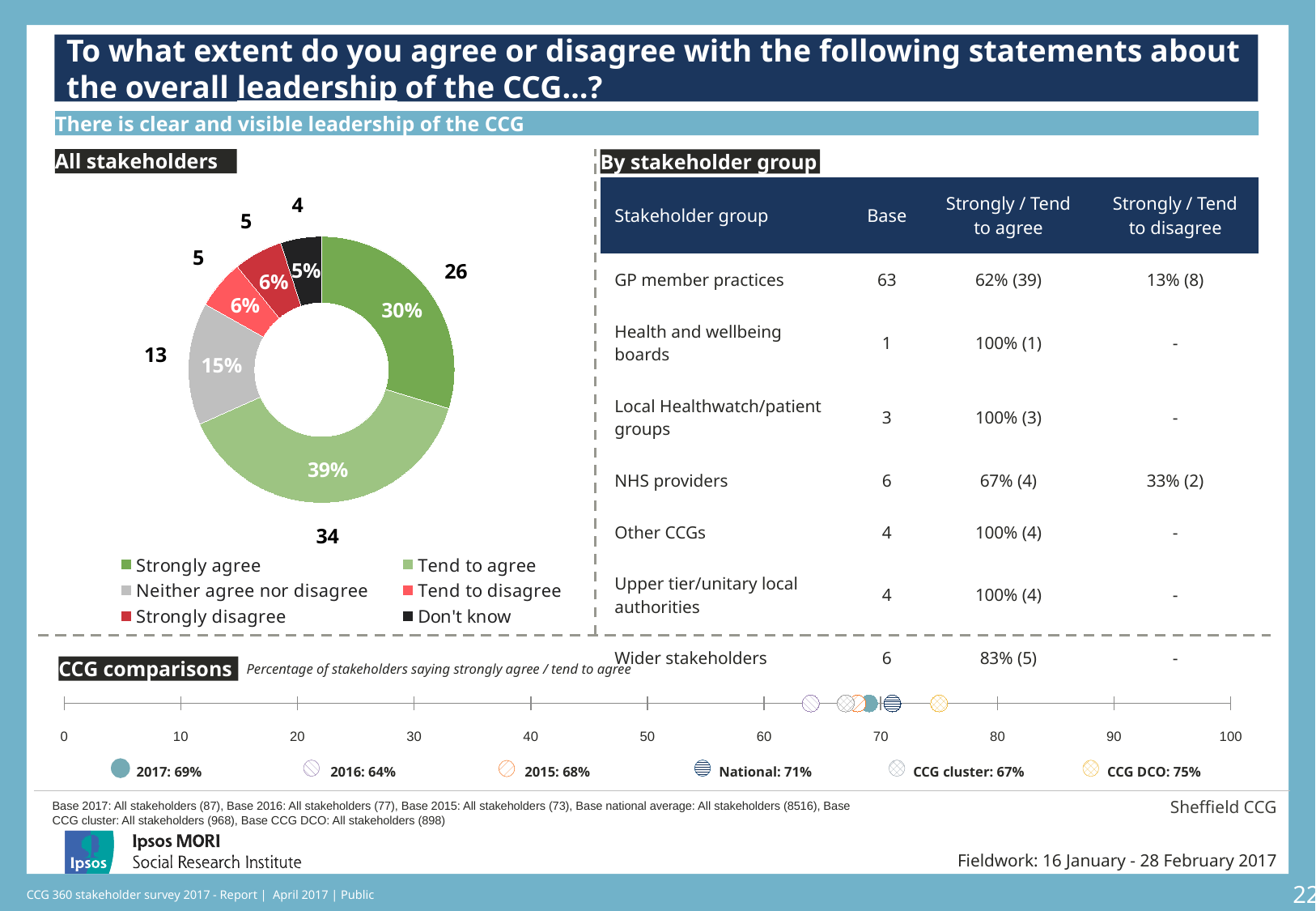
In the CCG comparisons chart, which comparator has the highest percentage? CCG DCO: 75% In the CCG comparisons chart, what percentage of stakeholders agreed in 2017? 69% How many response categories does the legend of the All stakeholders donut chart list? 6 In the All stakeholders donut chart, which response category has the largest share? Tend to agree In the All stakeholders donut chart, what percentage of stakeholders strongly agree? 30% In the All stakeholders donut chart, what is the difference in percentage points between Tend to agree and Strongly agree? 9 In the All stakeholders donut chart, which response category has the smallest share? Don't know In the All stakeholders donut chart, what percentage of stakeholders tend to agree? 39% In the All stakeholders donut chart, what percentage neither agree nor disagree? 15% What type of chart is used for the All stakeholders section? Donut (pie) chart In the CCG comparisons chart, is the 2017 value larger or smaller than the National value? Smaller In the All stakeholders donut chart, how many stakeholders (count) tend to agree? 34